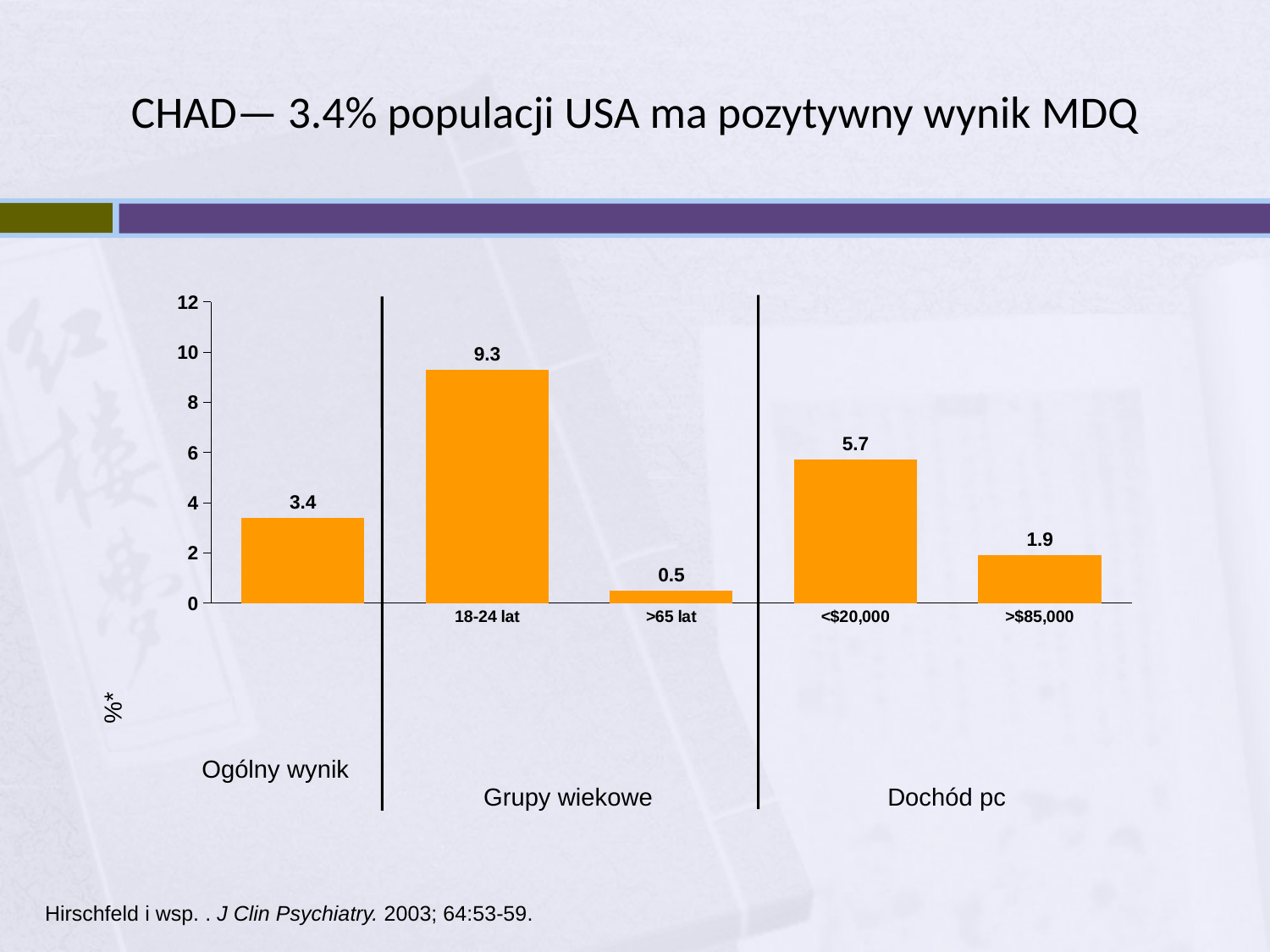
What is the value for the >65 lat age group? 0.5 What kind of chart is shown on the slide? Bar chart What is the value of the Ogólny wynik (overall) bar? 3.4 What is the difference between the values for 18-24 lat and >65 lat? 8.8 What is the difference between the values for <$20,000 and >$85,000? 3.8 What is the value for the <$20,000 income group? 5.7 Which category has the highest value? 18-24 lat What is the value for the >$85,000 income group? 1.9 How many bars are plotted in the chart? 5 Which is larger, the value for <$20,000 or the value for 18-24 lat? 18-24 lat Which category has the lowest value? >65 lat What is the value for the 18-24 lat age group? 9.3